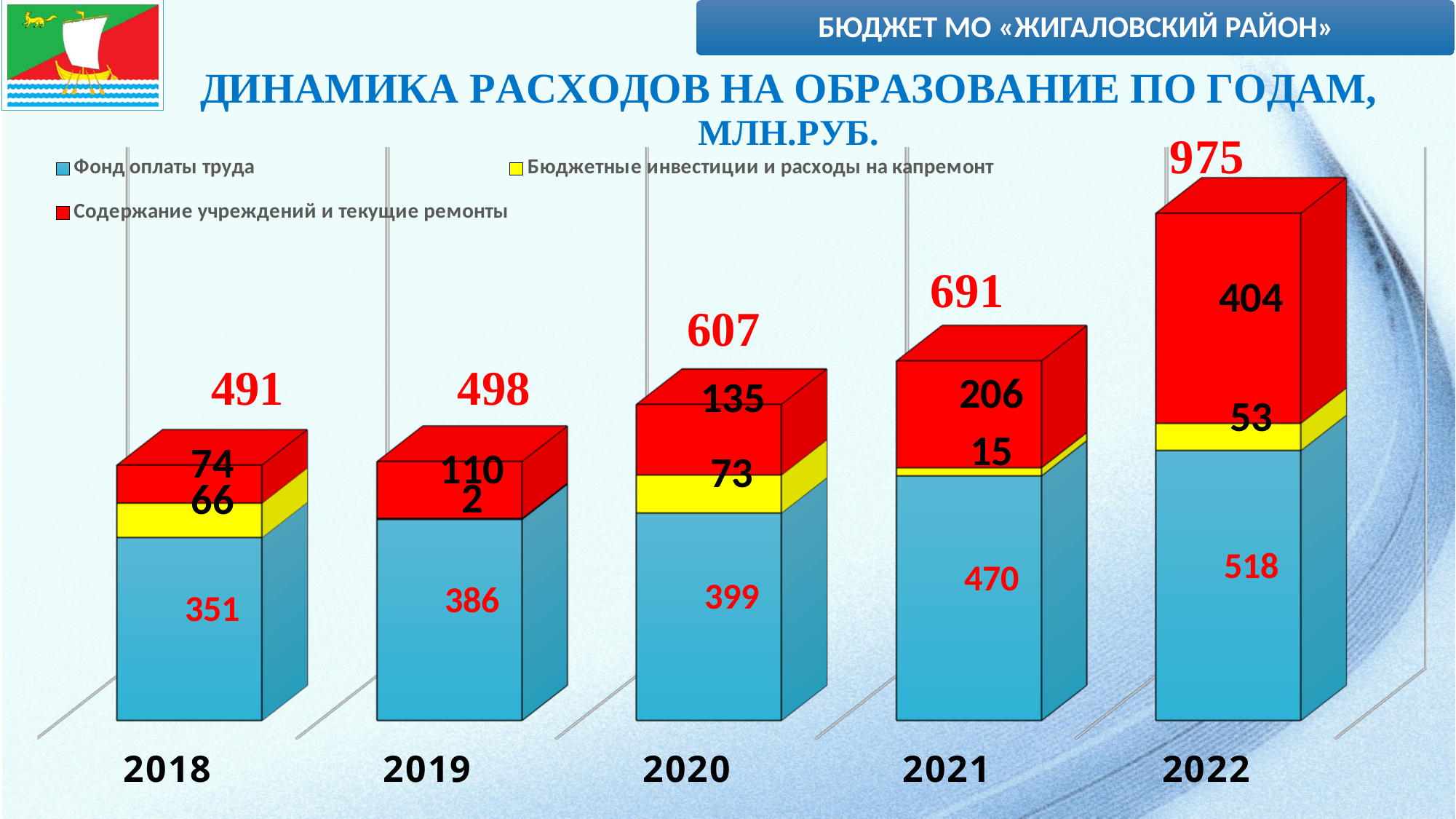
What is the total expenditure shown for 2021? 691 What kind of chart is shown on the slide? Stacked bar chart How many years are shown on the x axis? 5 Which is larger: Содержание учреждений и текущие ремонты in 2020 or in 2021? 2021 What is the value of Фонд оплаты труда for 2020? 399 What is the value of Содержание учреждений и текущие ремонты for 2022? 404 What is the value of Бюджетные инвестиции и расходы на капремонт for 2019? 2 How many series does the legend list? 3 Does the total expenditure rise or fall from 2018 to 2022? Rises Which year has the highest total expenditure on education? 2022 Which year has the lowest value for Бюджетные инвестиции и расходы на капремонт? 2019 What is the difference between the total for 2022 and the total for 2021? 284